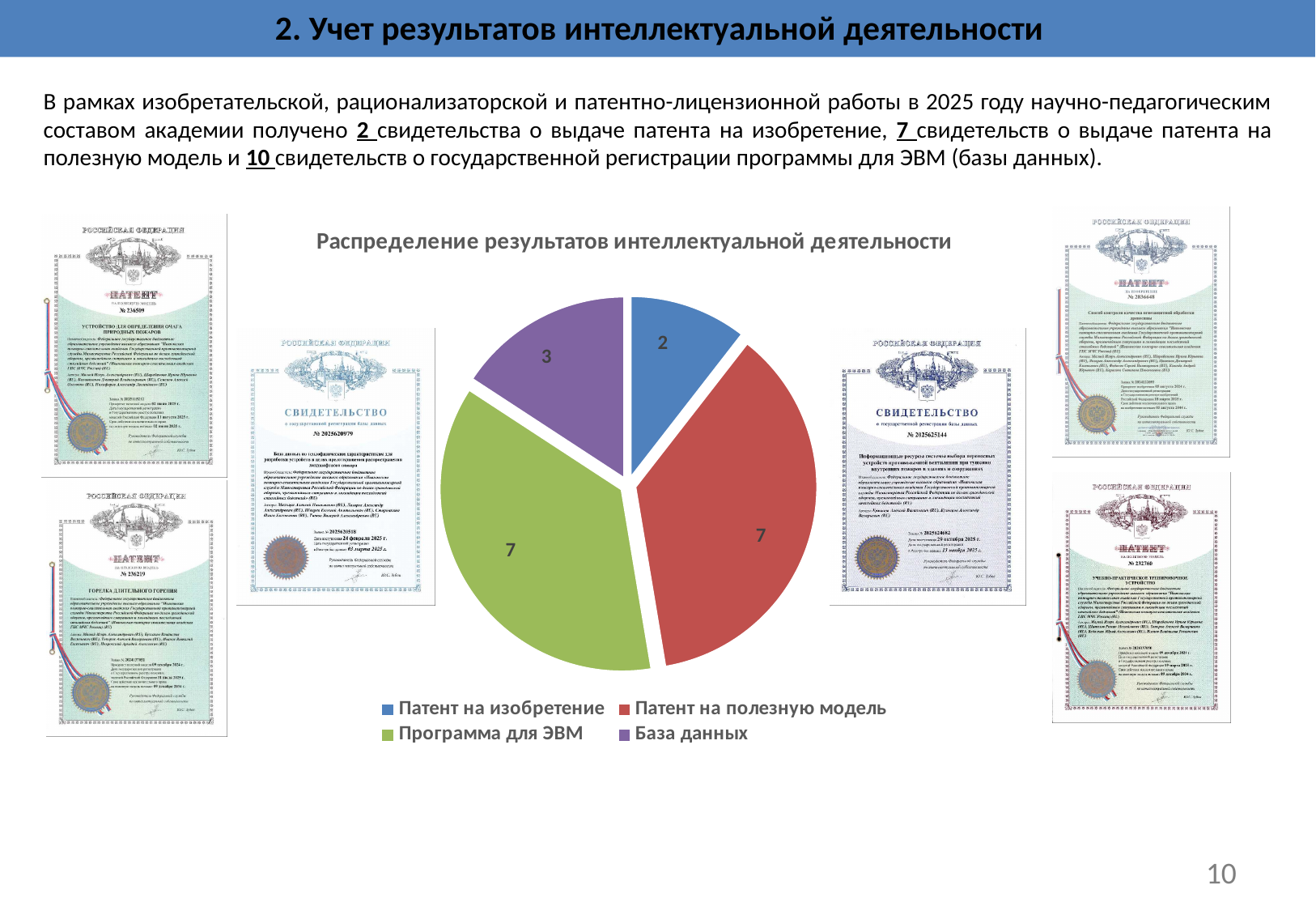
What is the value for Программа для ЭВМ? 7 What is the value for Патент на изобретение? 2 What colour represents База данных in the pie chart? Purple What is the title of the chart? Распределение результатов интеллектуальной деятельности Which category has the smallest slice in the pie chart? Патент на изобретение How many categories does the legend list? 4 What is the value for База данных? 3 What type of chart is shown on the slide? Pie chart Which is larger, the value for База данных or the value for Программа для ЭВМ? Программа для ЭВМ What is the value for Патент на полезную модель? 7 What is the difference between the values for Патент на полезную модель and Патент на изобретение? 5 How many slices does the pie chart have? 4